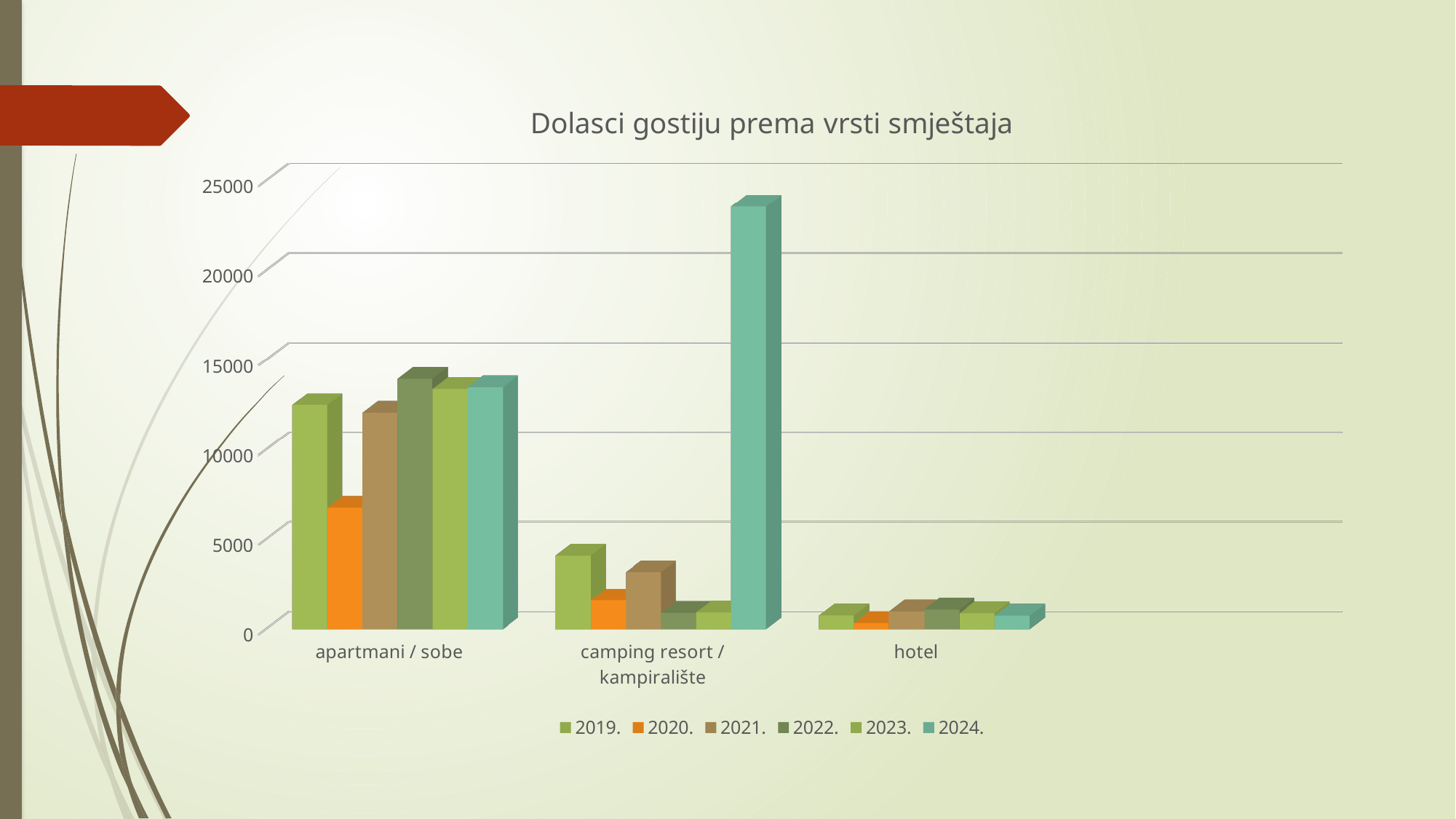
Which series has the tallest bar for camping resort / kampiralište? 2024. Is the 2019. value for camping resort / kampiralište greater or less than 5000? less Which category has the tallest bar in the chart? camping resort / kampiralište Which series has the lowest bar for apartmani / sobe? 2020. How many accommodation categories are shown on the x axis? 3 Is the 2020. value for apartmani / sobe greater or less than 10000? less Which is larger: the 2019. value for apartmani / sobe or the 2019. value for hotel? apartmani / sobe What kind of chart is shown on the slide? bar chart Which year does the last legend entry represent? 2024. What is the title of the chart? Dolasci gostiju prema vrsti smještaja How many series does the legend list? 6 Is the 2024. value for camping resort / kampiralište greater or less than 20000? greater